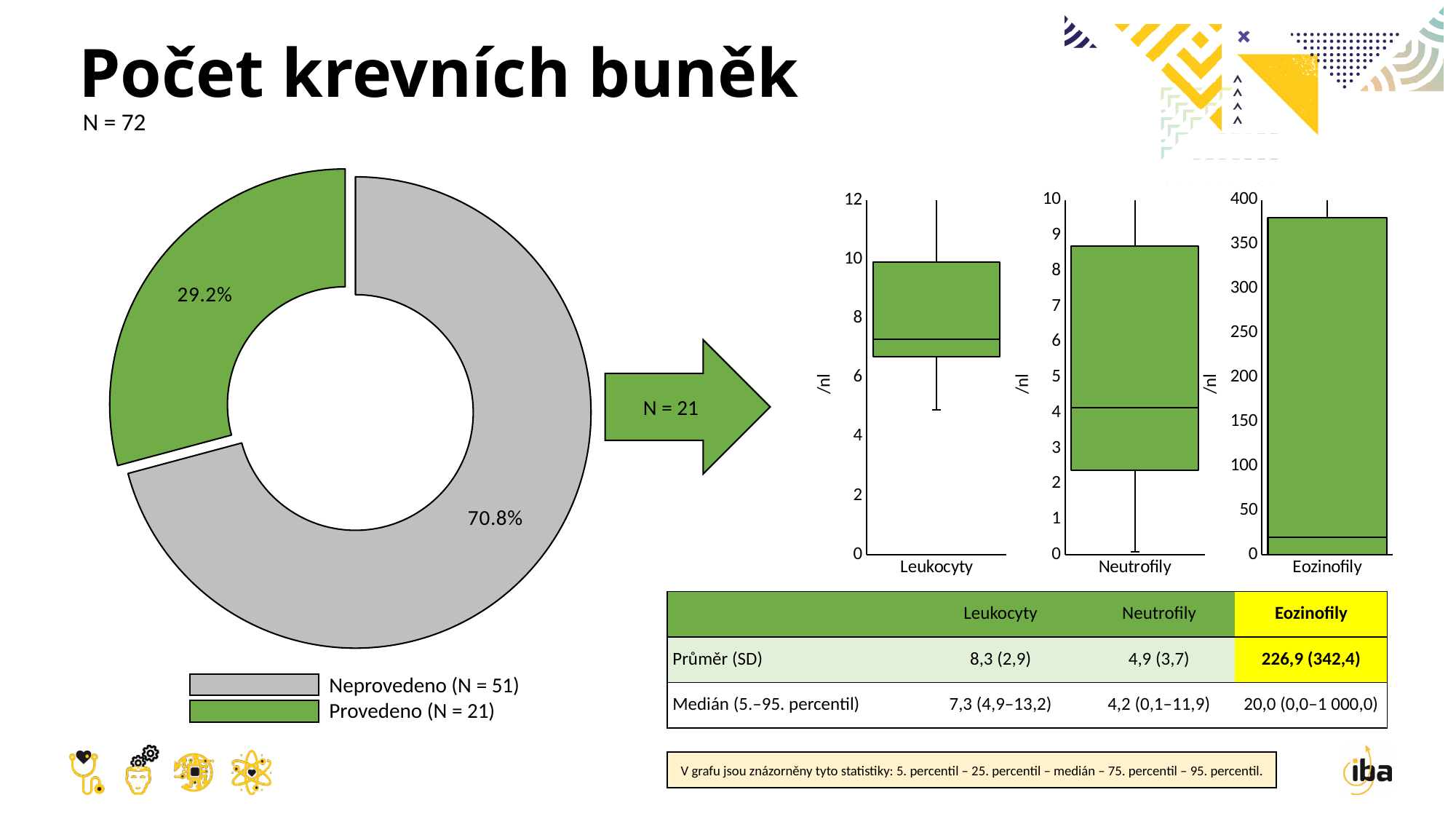
How many box plots are shown on the right side of the slide? 3 In the donut chart on the left, what N is given in the legend for Neprovedeno? N = 51 In the Neutrofily box plot, is the median line greater or less than 5? less In the Leukocyty box plot, is the median line greater or less than 6? greater In the donut chart on the left, what N is given in the legend for Provedeno? N = 21 What kind of chart is the chart on the left of the slide? Pie (donut) chart In the Eozinofily box plot, what is the highest value shown on the y axis? 400 In the donut chart on the left, how many categories are shown? 2 In the donut chart on the left, what percentage is shown for the Provedeno slice? 29.2% In the donut chart on the left, what percentage is shown for the Neprovedeno slice? 70.8% In the donut chart on the left, which slice is larger, Neprovedeno or Provedeno? Neprovedeno What unit label is shown on the y axis of the Leukocyty box plot? /nl